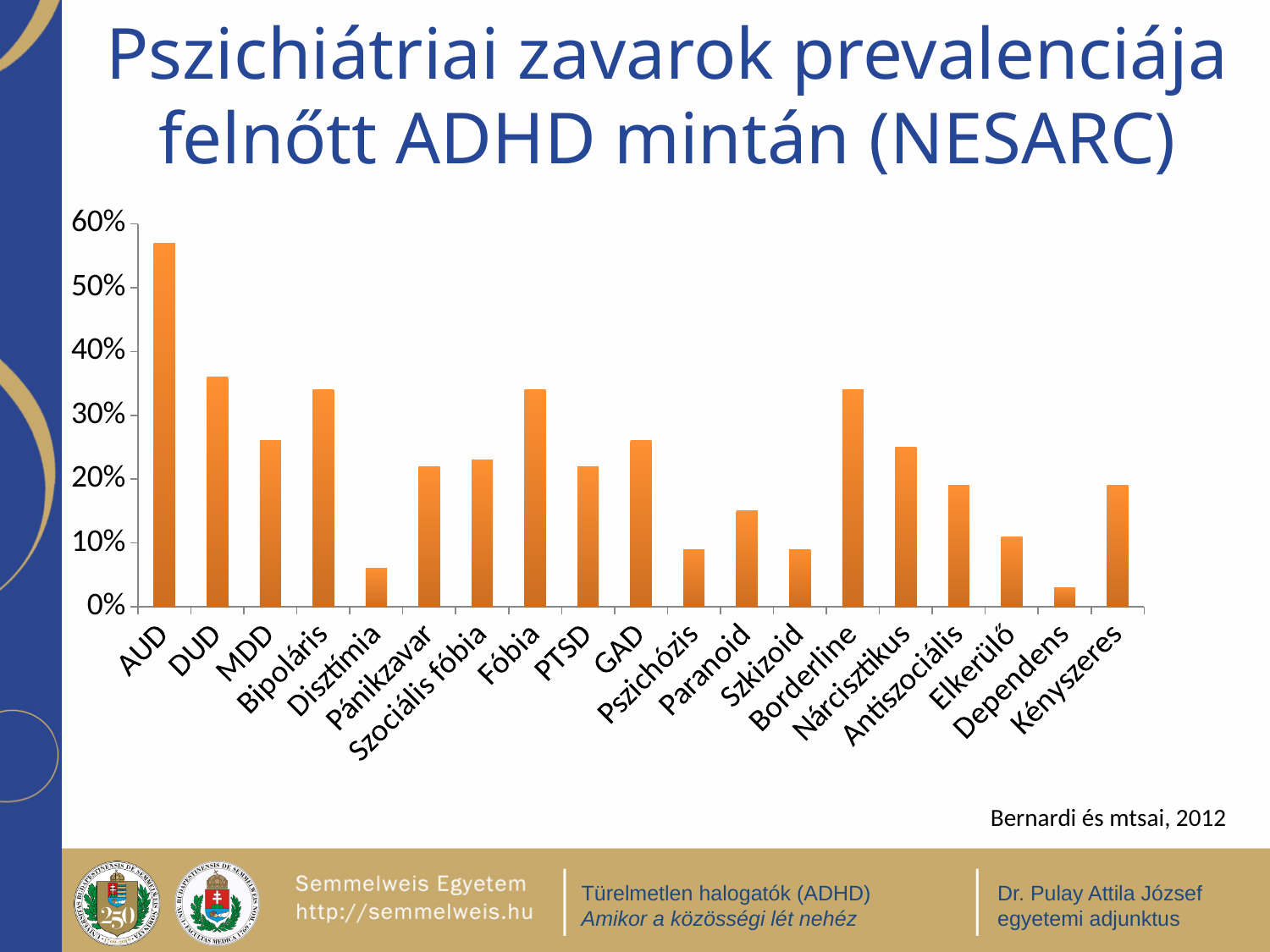
What kind of chart is shown on the slide? bar chart Is the value for Nárcisztikus greater or less than 20%? greater Which is larger, the value for AUD or the value for DUD? AUD Is the value for AUD greater or less than 50%? greater What is the title of the slide containing the chart? Pszichiátriai zavarok prevalenciája felnőtt ADHD mintán (NESARC) How many categories (disorders) are plotted on the x axis? 19 Is the value for Borderline greater or less than 30%? greater Which is larger, the value for Bipoláris or the value for MDD? Bipoláris Which category has the highest prevalence? AUD Which category has the lowest prevalence? Dependens